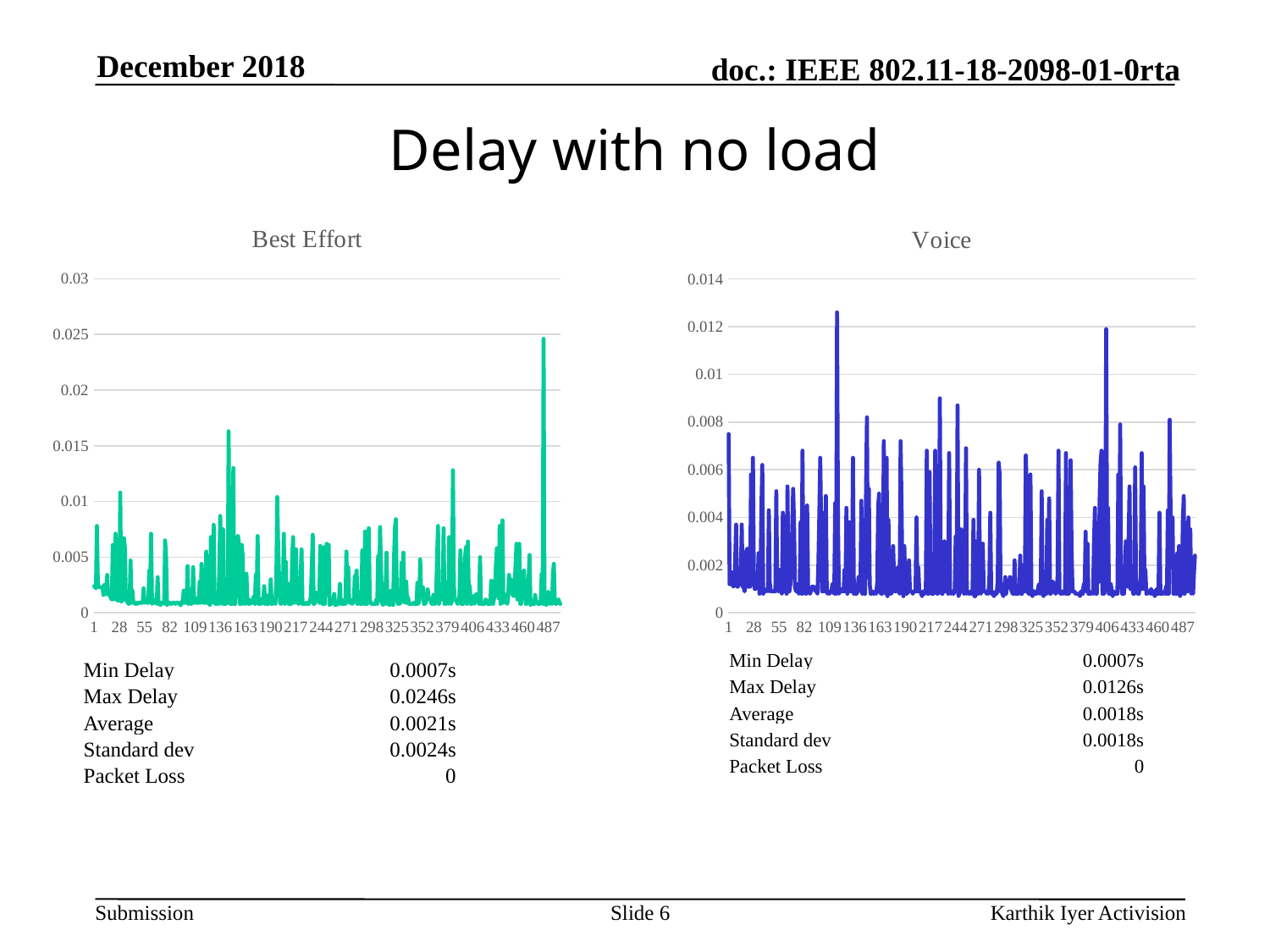
What is the title of the chart on the right side of the slide? Voice In the Best Effort chart, is the highest peak of the line greater or less than 0.02? greater What is the title of the chart on the left side of the slide? Best Effort How many lines are plotted in the Voice chart? 1 In the Voice chart, is the highest peak of the line greater or less than 0.01? greater In the Voice chart, is the highest peak of the line greater or less than 0.014? less According to the figures printed below the Best Effort chart, what is the Max Delay? 0.0246s Which chart reaches a higher peak value, Best Effort or Voice? Best Effort What is the highest value shown on the y axis of the Best Effort chart? 0.03 What kind of chart is the Voice chart? line chart What kind of chart is the Best Effort chart? line chart According to the figures printed below the Voice chart, what is the Max Delay? 0.0126s